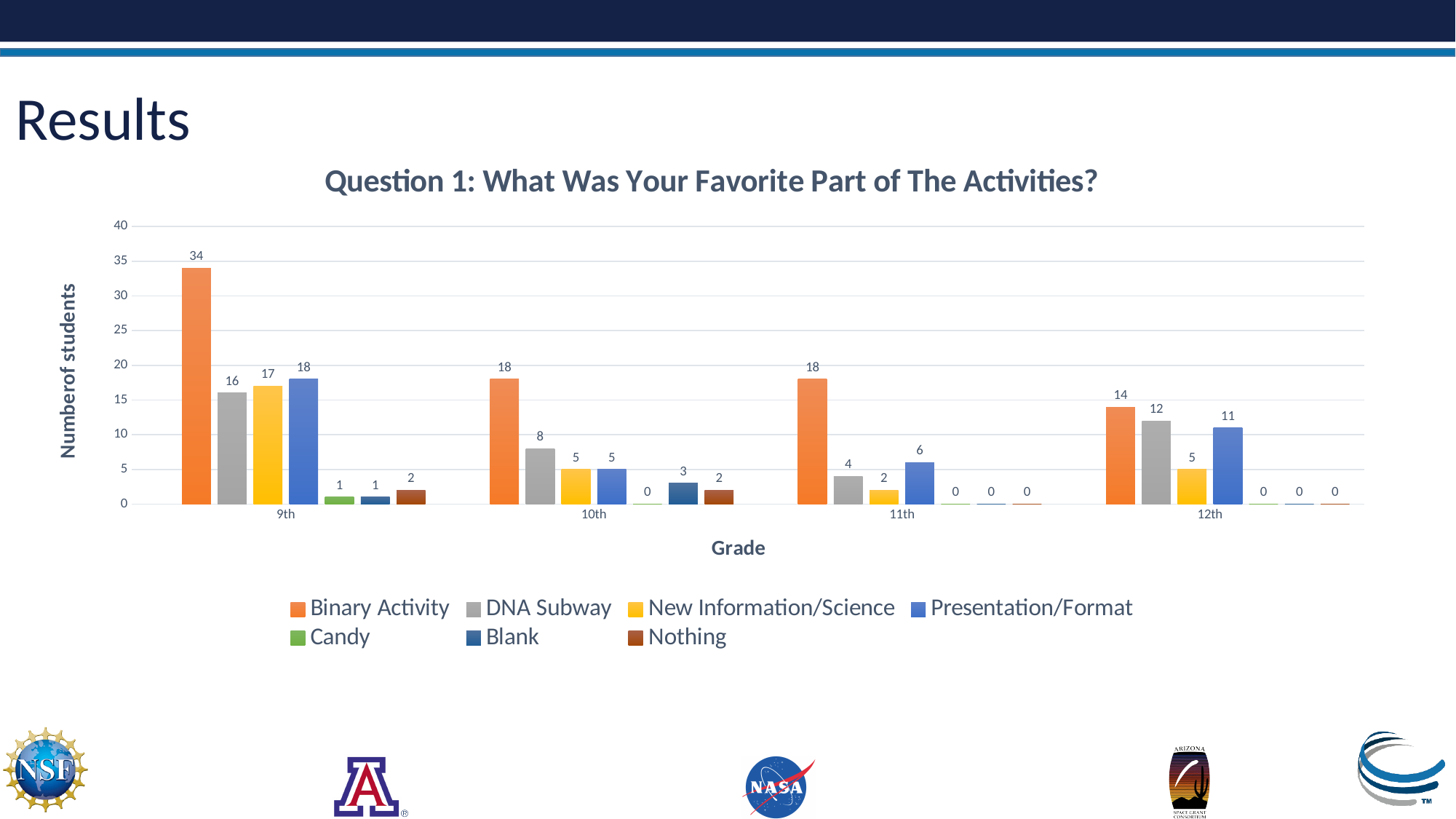
What is the difference between Binary Activity and DNA Subway in 10th grade? 10 Which is larger in 12th grade, DNA Subway or Presentation/Format? DNA Subway What is the value for DNA Subway in 12th grade? 12 How many series does the legend list? 7 What is the value for Binary Activity in 9th grade? 34 What kind of chart is shown? bar chart How many grade categories are shown on the x axis? 4 What is the title of the chart? Question 1: What Was Your Favorite Part of The Activities? What is the label of the y axis? Numberof students Which grade has the lowest value for New Information/Science? 11th What is the value for Presentation/Format in 11th grade? 6 Which grade has the highest value for Binary Activity? 9th